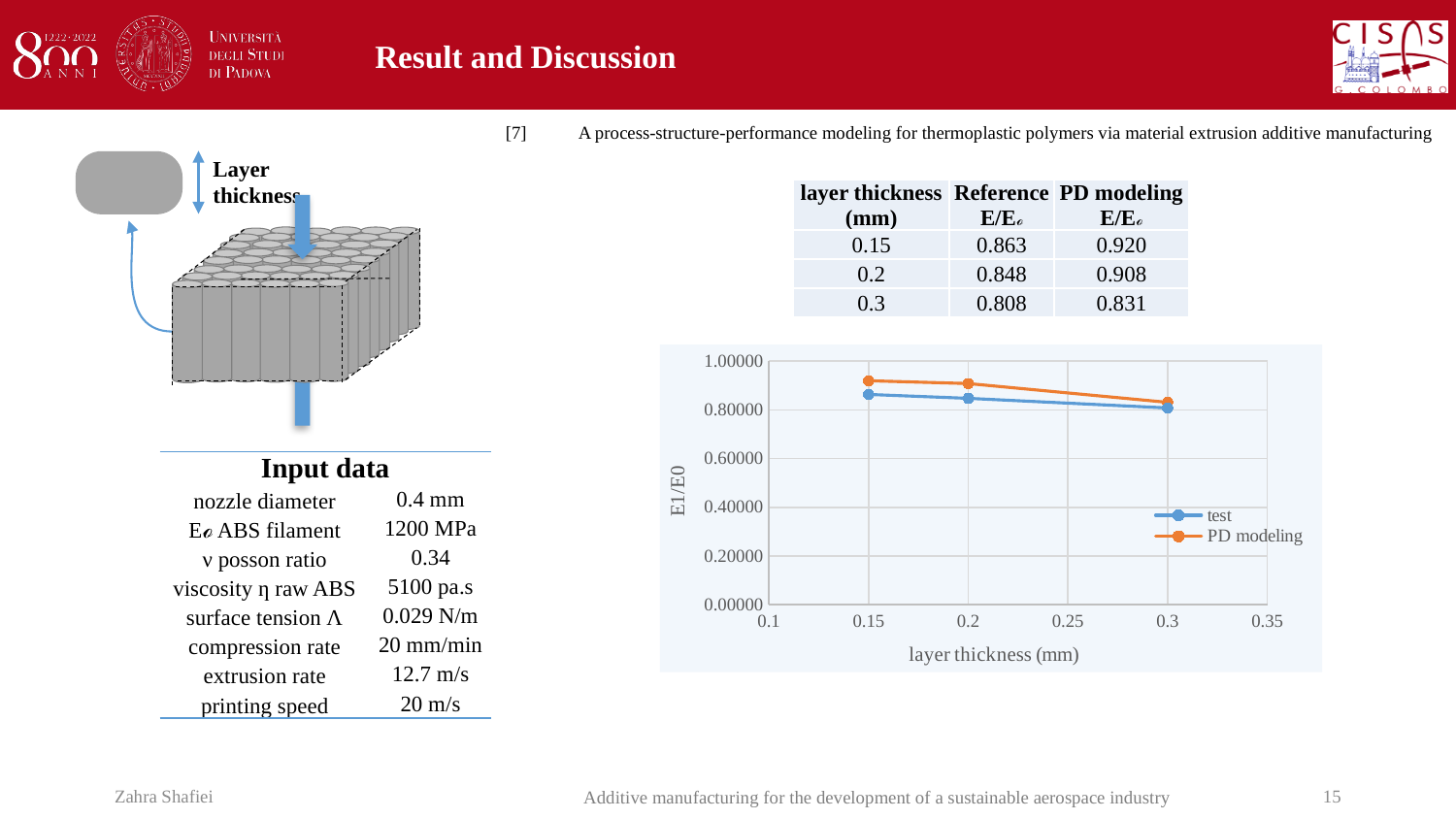
How many data points are plotted for the test series? 3 At which layer thickness is the E1/E0 value for the PD modeling series lowest? 0.3 At layer thickness 0.15, which series has the higher E1/E0 value, test or PD modeling? PD modeling What kind of chart is shown on the slide? line chart Is the E1/E0 value for the test series at layer thickness 0.3 greater or less than 1.00000? less What is the label of the chart's x axis? layer thickness (mm) Is the E1/E0 value for the PD modeling series at layer thickness 0.15 greater or less than 0.80000? greater What are the two series named in the chart legend? test and PD modeling How many series does the chart legend list? 2 Is the E1/E0 value for the test series at layer thickness 0.2 greater or less than 0.60000? greater Does the E1/E0 value for the PD modeling series rise or fall as layer thickness increases? fall Does the E1/E0 value for the test series rise or fall as layer thickness increases? fall